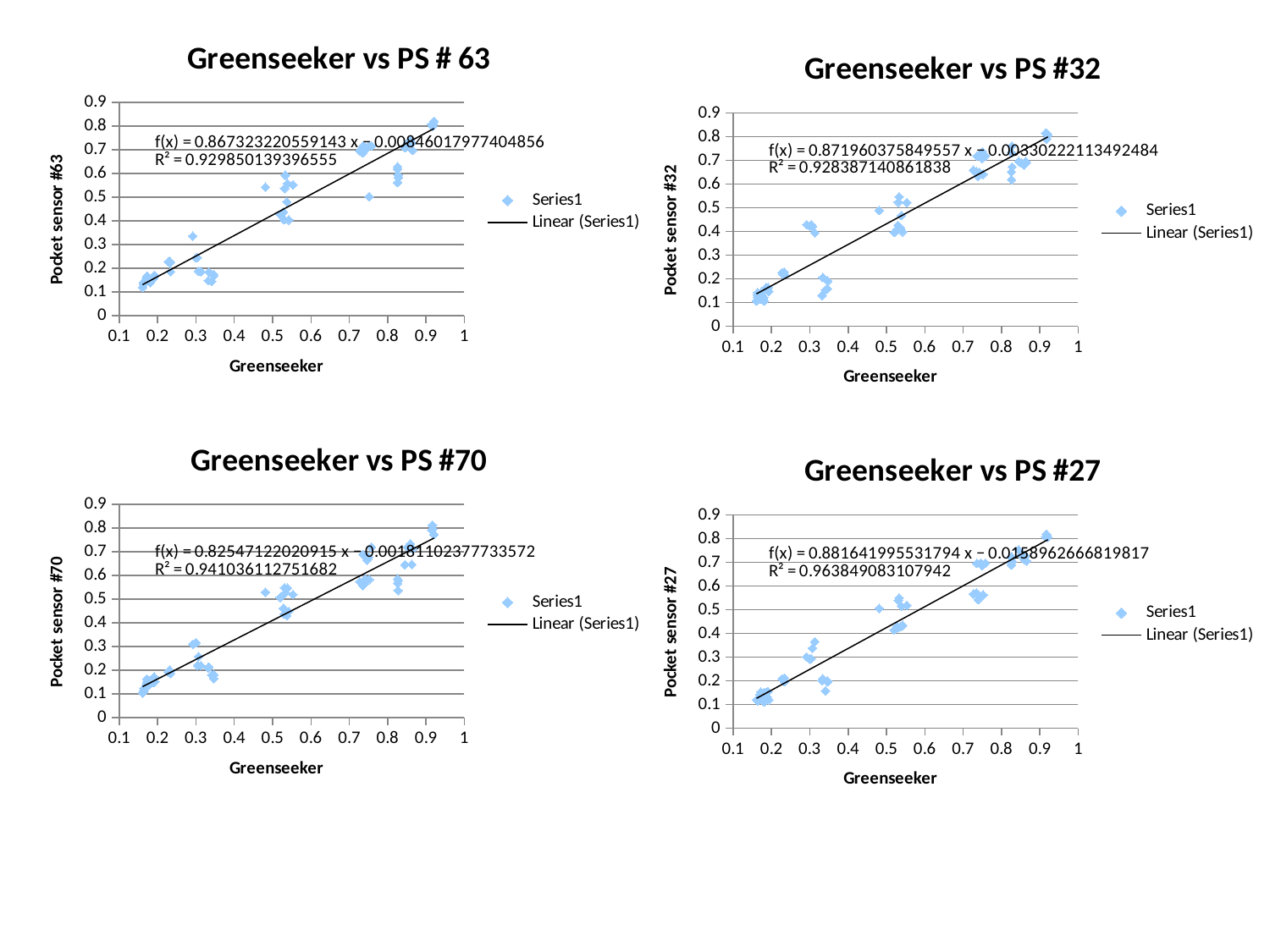
What is the label of the x axis on the "Greenseeker vs PS #70" chart? Greenseeker Which of the four charts has the highest R² value? Greenseeker vs PS #27 In the "Greenseeker vs PS #70" chart, do the Pocket sensor values rise or fall as Greenseeker increases? rise In the "Greenseeker vs PS # 63" chart, what is the R² value shown? 0.929850139396555 In the "Greenseeker vs PS #27" chart, what is the R² value shown? 0.963849083107942 In the "Greenseeker vs PS #32" chart, what is the R² value shown? 0.928387140861838 How many entries does the legend of the "Greenseeker vs PS #27" chart list? 2 In the "Greenseeker vs PS #70" chart, what is the R² value shown? 0.941036112751682 What kind of chart is "Greenseeker vs PS # 63"? scatter chart What is the label of the y axis on the "Greenseeker vs PS #32" chart? Pocket sensor #32 Which of the four charts has the lowest R² value? Greenseeker vs PS #32 In the "Greenseeker vs PS #27" chart, is the Pocket sensor value of the point at the highest Greenseeker reading greater or less than 0.7? greater